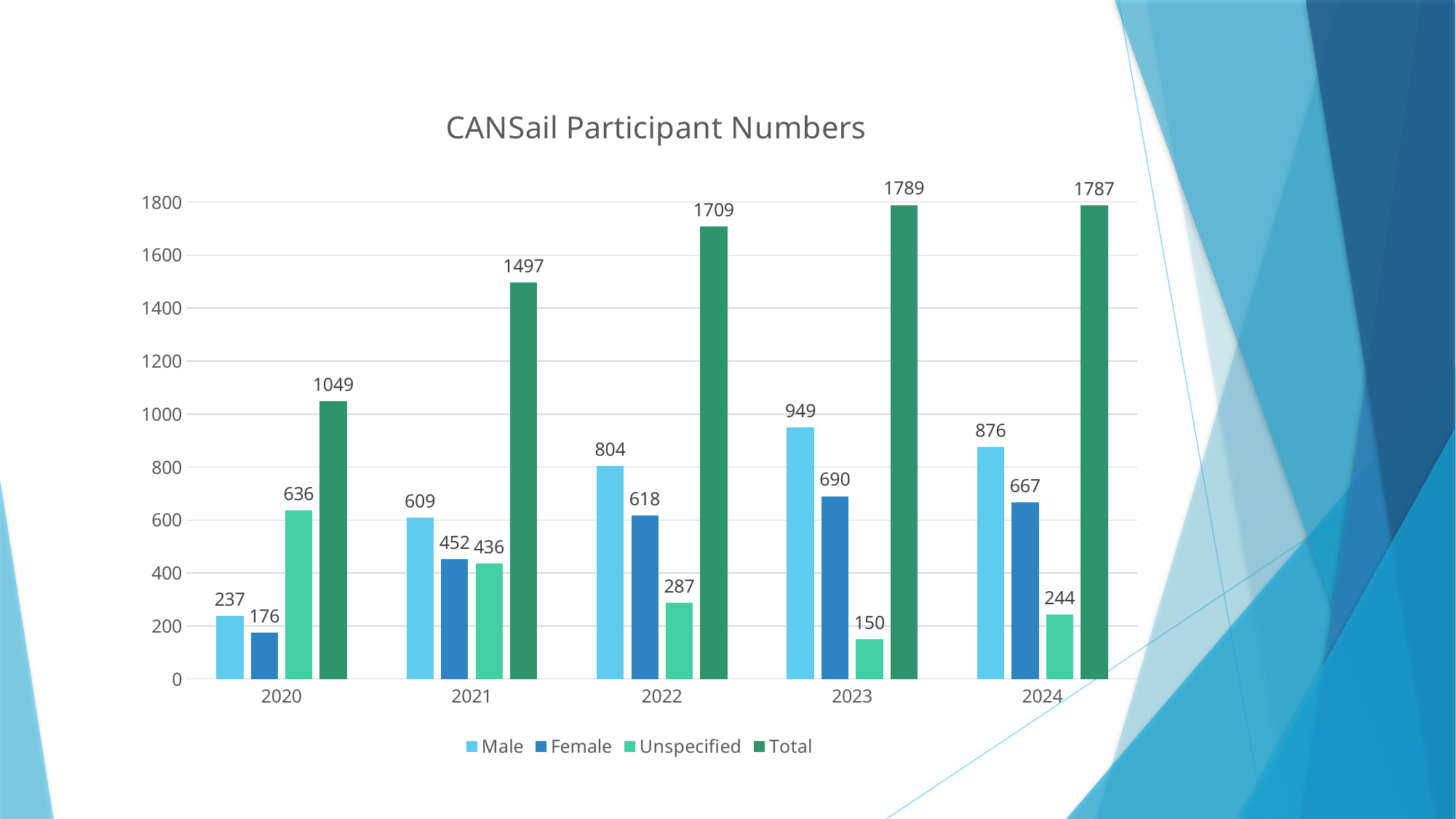
What is the Total participant number for 2021? 1497 Which year has the highest Total participant number? 2023 How many series does the legend list? 4 What is the Male participant number for 2023? 949 What is the difference between the Male and Female participant numbers in 2024? 209 Which is larger in 2021, the Female value or the Unspecified value? Female What is the title of the chart? CANSail Participant Numbers Does the Unspecified participant number rise or fall from 2020 to 2023? Fall What is the Unspecified participant number for 2020? 636 How many years are shown on the x axis? 5 Which year has the lowest Female participant number? 2020 What kind of chart is shown on the slide? Bar chart